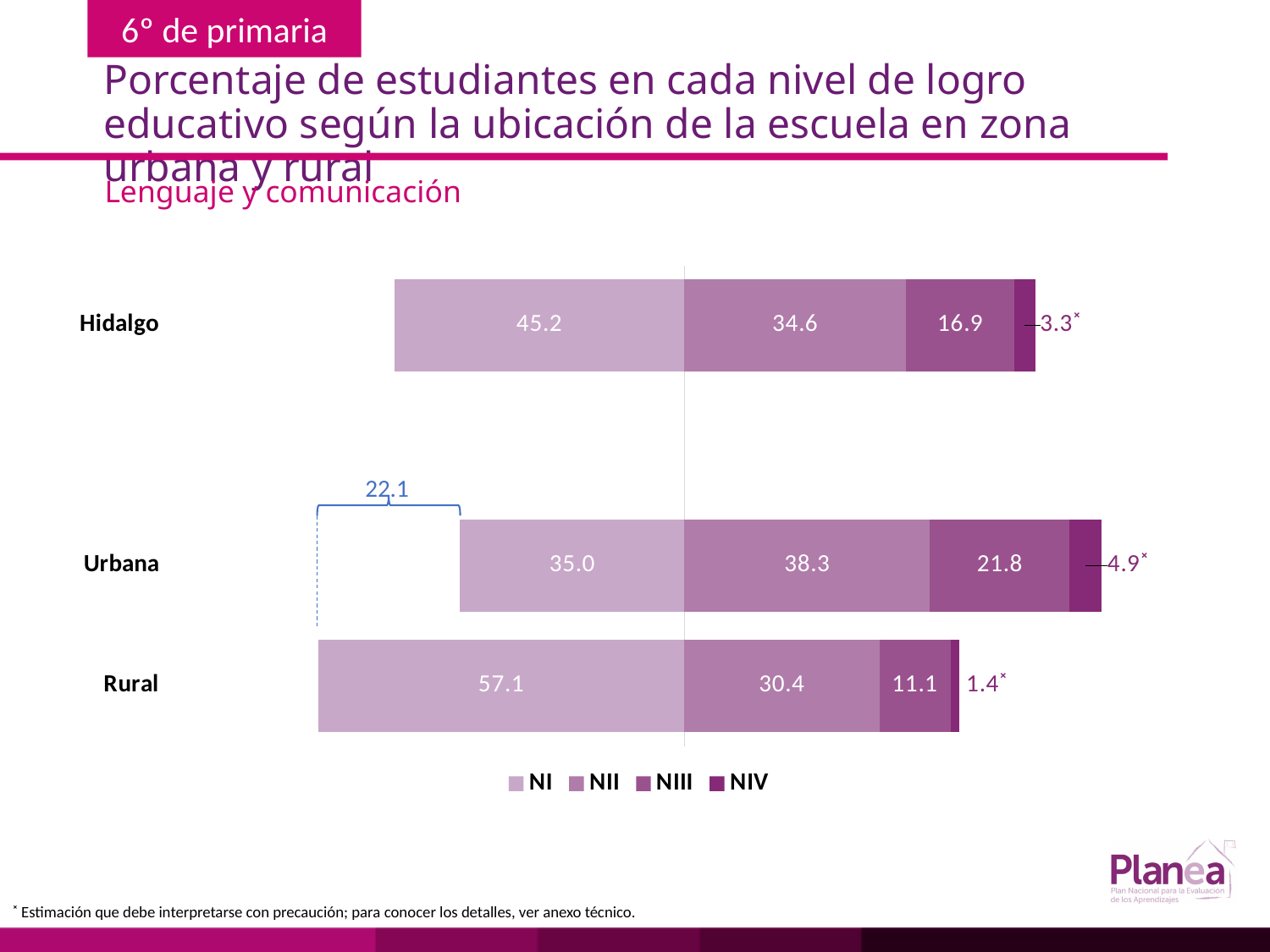
Which is larger, the NIII value for Urbana or the NIII value for Hidalgo? Urbana How many categories (bars) are plotted in the chart? 3 What is the NIII value for Hidalgo? 16.9 What is the NI value for Rural? 57.1 What type of chart is shown on the slide? stacked bar chart What is the difference between the NI values for Rural and Urbana? 22.1 Which category has the highest NI value? Rural Which category has the lowest NIV value? Rural How many series does the legend list? 4 What is the subtitle shown above the chart? Lenguaje y comunicación What is the NII value for Urbana? 38.3 What is the NIV value for Urbana? 4.9